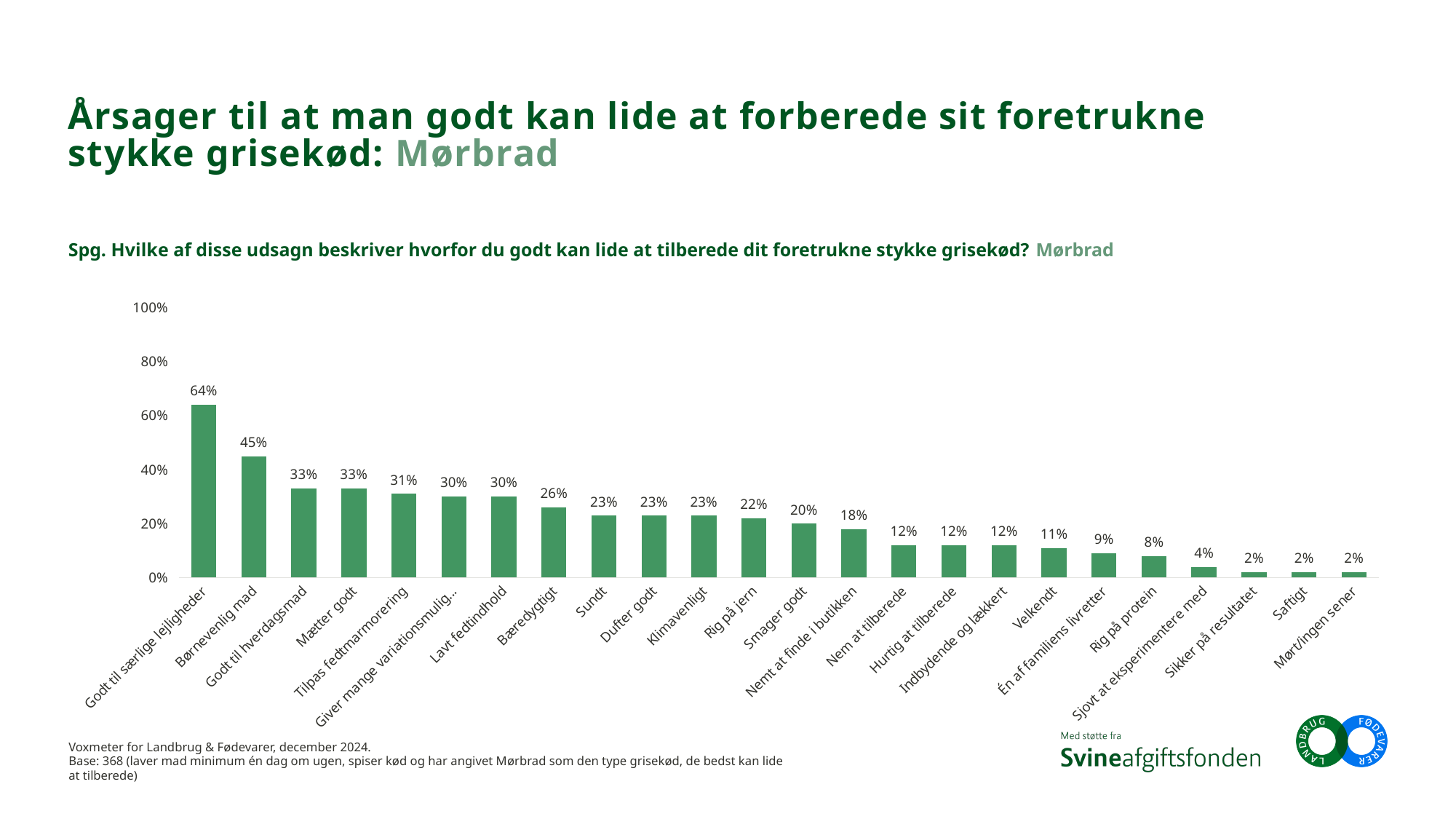
How many categories are shown on the chart? 24 What is the highest tick value shown on the y axis? 100% What is the difference between "Godt til særlige lejligheder" and "Børnevenlig mad"? 19 percentage points Which category has the highest value? Godt til særlige lejligheder What is the value for "Børnevenlig mad"? 45% What is the lowest value shown on the chart? 2% What percentage is shown for "Smager godt"? 20% Which is larger, "Bæredygtigt" or "Rig på jern"? Bæredygtigt What is the value for "Velkendt"? 11% Do the values rise or fall from left to right along the x axis? Fall What percentage is shown for "Godt til særlige lejligheder"? 64% What kind of chart is shown on the slide? Bar chart